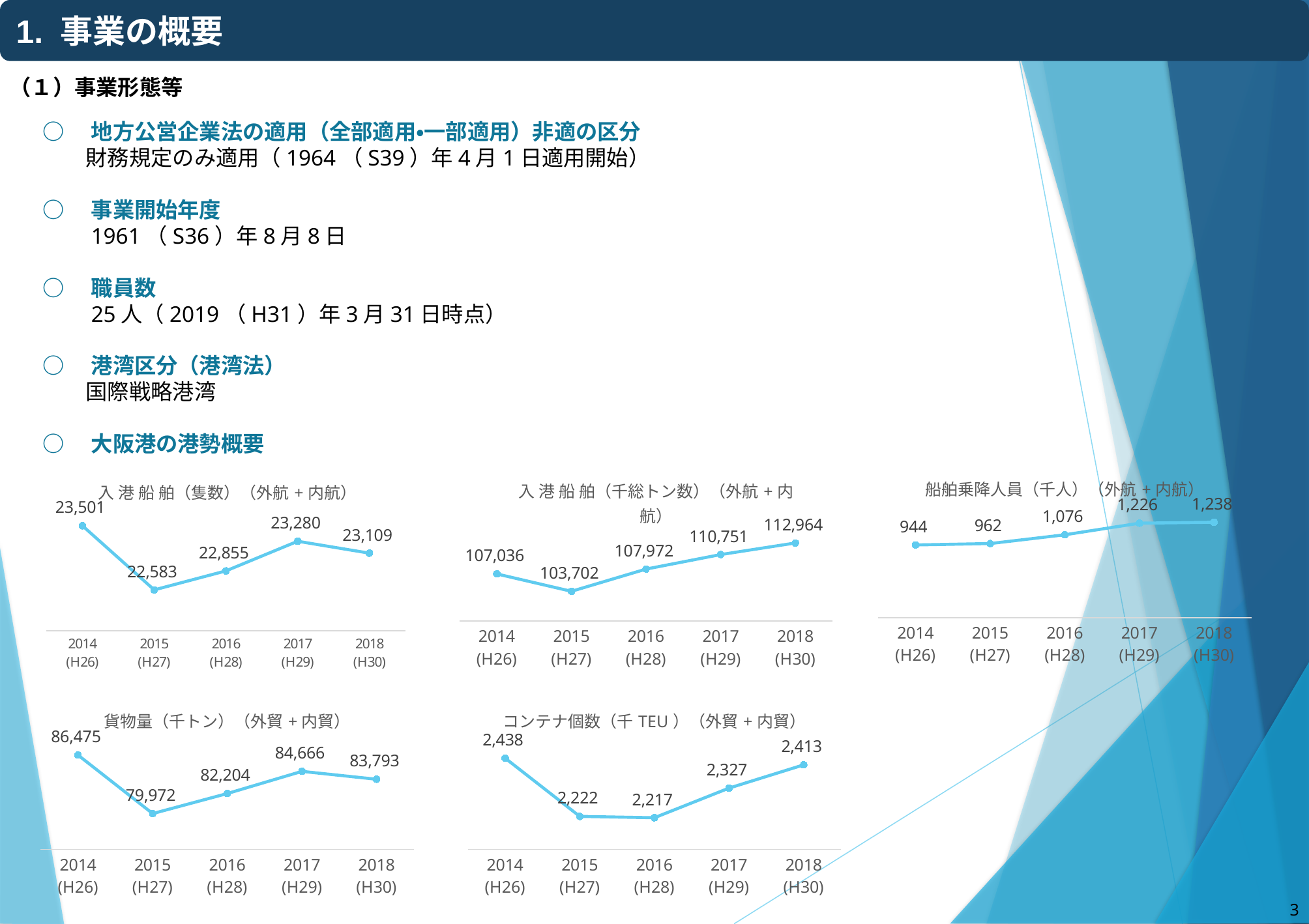
In the コンテナ個数（千TEU）（外貿＋内貿） chart, which is larger, the value for 2014 (H26) or 2018 (H30)? 2014 (H26) What type of chart is the 入港船舶（隻数）（外航＋内航） chart? line chart In the 入港船舶（千総トン数）（外航＋内航） chart, what is the value for 2018 (H30)? 112,964 In the 入港船舶（千総トン数）（外航＋内航） chart, what is the difference between the 2018 (H30) and 2014 (H26) values? 5,928 In the 船舶乗降人員（千人）（外航＋内航） chart, what is the value for 2016 (H28)? 1,076 In the 入港船舶（隻数）（外航＋内航） chart, what is the value for 2014 (H26)? 23,501 In the 船舶乗降人員（千人）（外航＋内航） chart, do the values rise or fall from 2014 to 2018? rise How many data points does the 貨物量（千トン）（外貿＋内貿） chart show? 5 In the 入港船舶（隻数）（外航＋内航） chart, which year has the lowest value? 2015 (H27) In the コンテナ個数（千TEU）（外貿＋内貿） chart, what is the difference between the 2015 (H27) and 2016 (H28) values? 5 In the 貨物量（千トン）（外貿＋内貿） chart, which year has the highest value? 2014 (H26) In the 貨物量（千トン）（外貿＋内貿） chart, what is the value for 2017 (H29)? 84,666